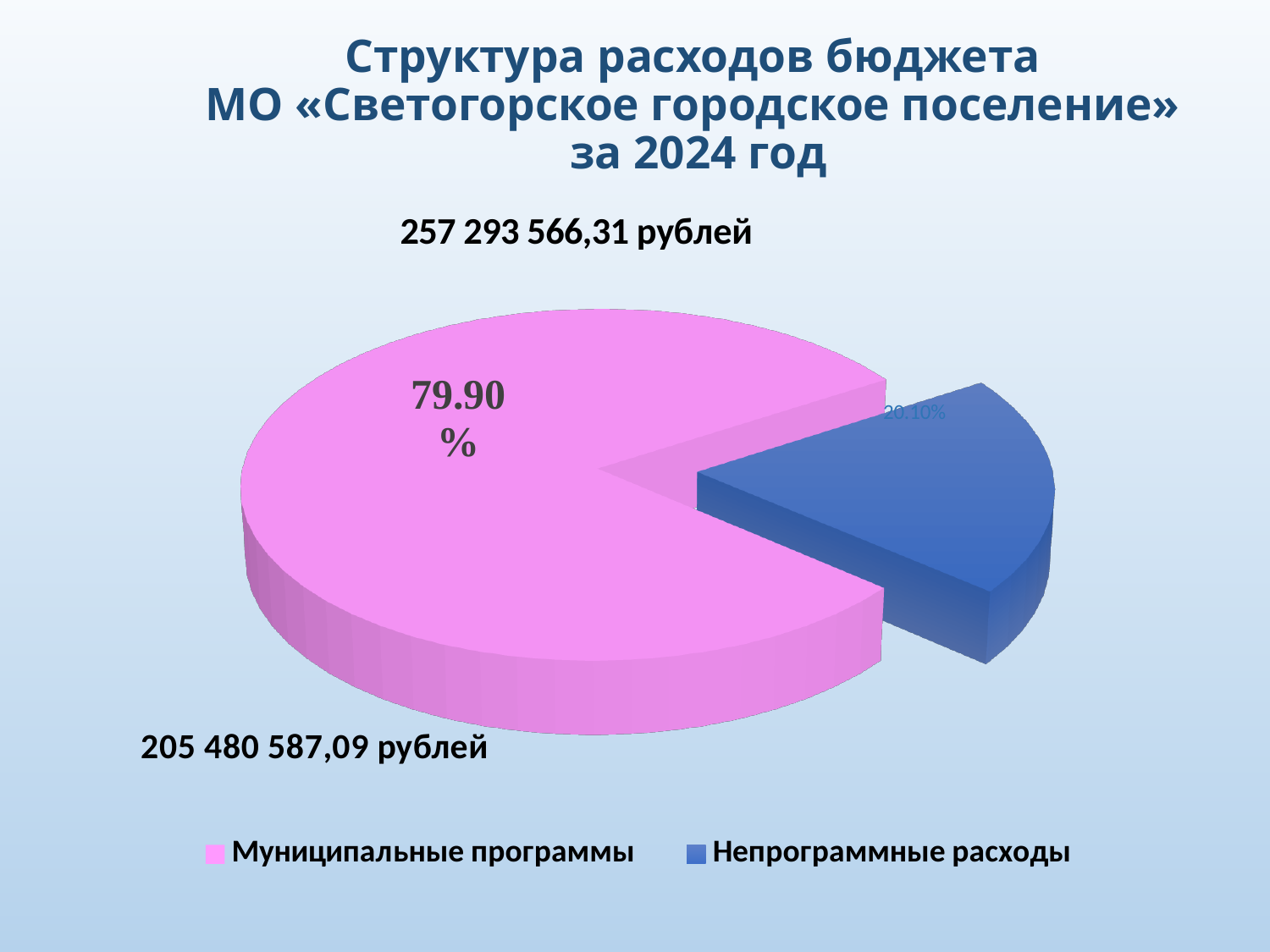
What share of the pie does the slice for Муниципальные программы represent? 79.90% What kind of chart is shown on the slide? pie chart What year does the chart title say the budget expenditure structure is for? 2024 Which category has the largest slice of the pie? Муниципальные программы What colour is the slice for Непрограммные расходы? blue What is the difference in percentage points between the share for Муниципальные программы and the share for Непрограммные расходы? 59.80 percentage points How many entries does the legend list? 2 Which is larger: the share for Муниципальные программы or the share for Непрограммные расходы? Муниципальные программы How many slices does the pie chart have? 2 Is the share for Непрограммные расходы greater or less than 25%? less What share of the pie does the slice for Непрограммные расходы represent? 20.10% Which category has the smallest slice of the pie? Непрограммные расходы